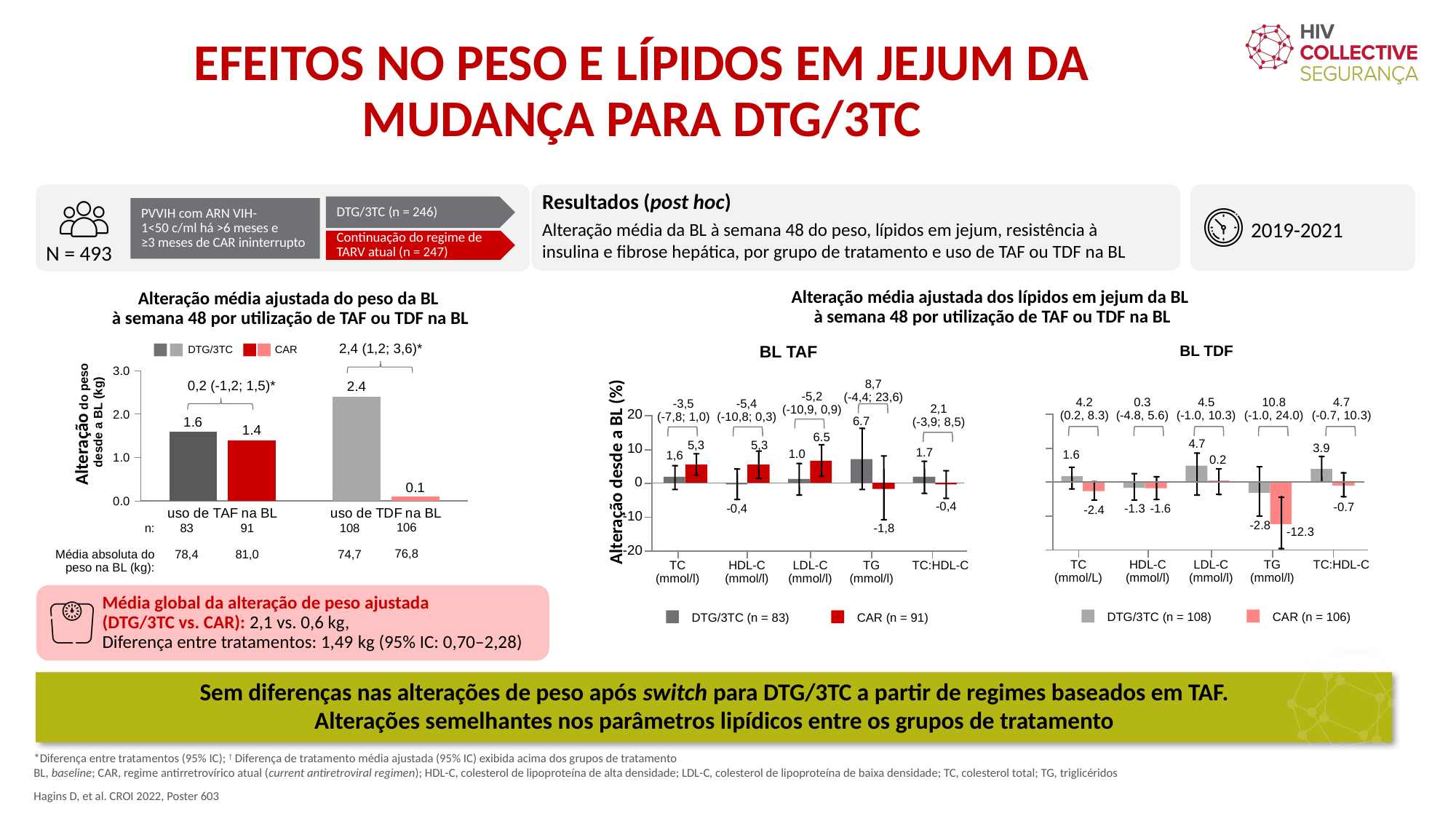
In the weight change chart on the left, what is the value for DTG/3TC among participants using TDF at baseline? 2.4 In the weight change chart on the left, which bar is the lowest? CAR, uso de TDF na BL (0.1) In the BL TDF chart, what is the value for CAR for TG? -12.3 In the BL TDF chart, what is the difference between the DTG/3TC and CAR values for LDL-C? 4.5 In the weight change chart on the left, what is the difference between the DTG/3TC and CAR bars for participants using TDF at baseline? 2.3 In the weight change chart on the left, how many bars are plotted? 4 In the BL TDF chart, which category has the lowest CAR value? TG In the weight change chart on the left, what is the value for CAR among participants using TAF at baseline? 1.4 In the BL TAF chart, what is the value for DTG/3TC for TG? 6.7 In the BL TAF chart, which is larger for HDL-C: DTG/3TC or CAR? CAR What type of chart is the BL TDF chart? Bar chart In the BL TAF chart, what is the value for CAR for LDL-C? 6.5